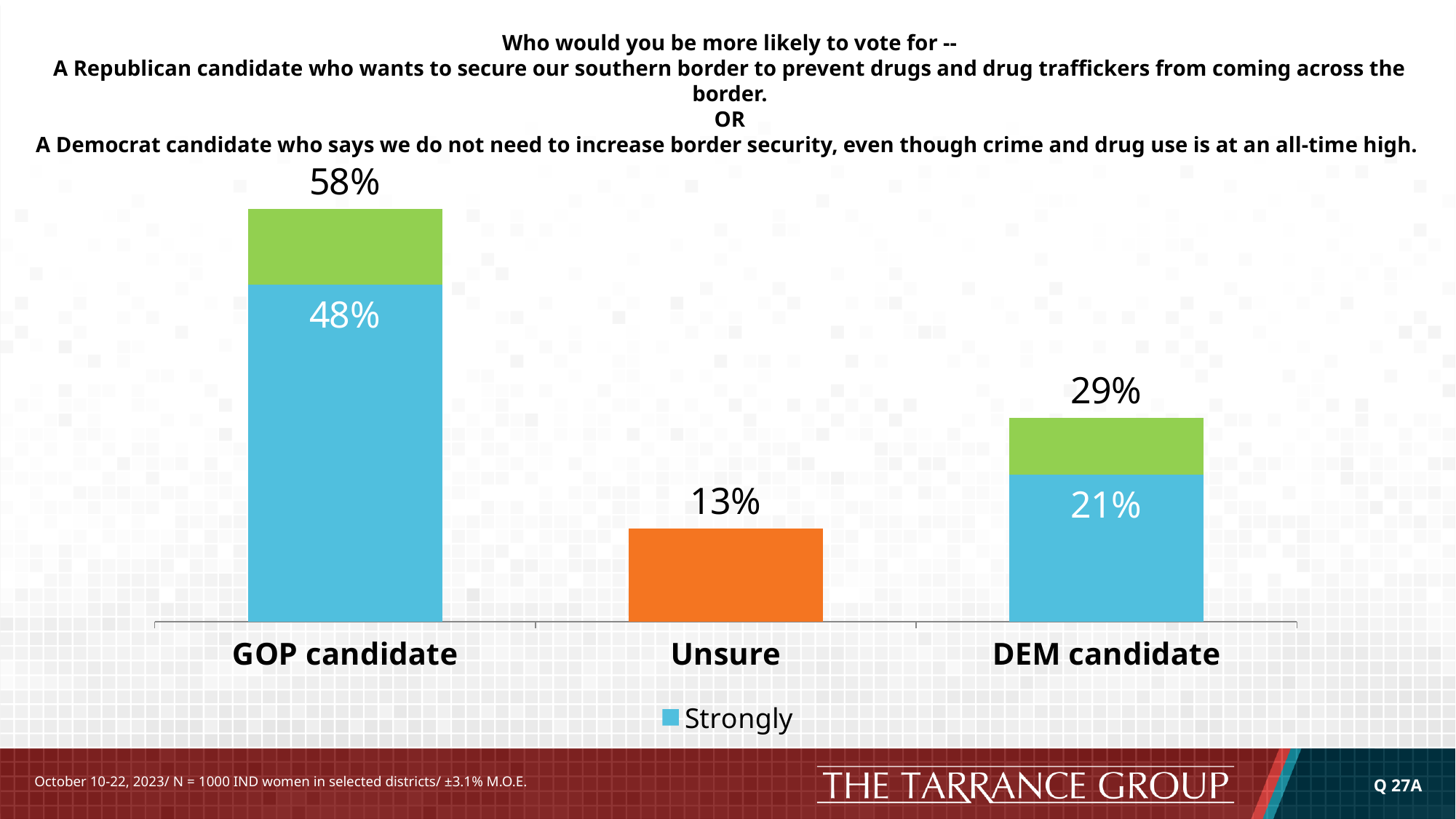
What is the difference between the 'Strongly' values for GOP candidate and DEM candidate? 27% What is the 'Strongly' value for DEM candidate? 21% What is the value for Unsure? 13% Which category has the lowest value? Unsure What is the total value shown for GOP candidate? 58% What is the total value shown for DEM candidate? 29% What is the 'Strongly' value for GOP candidate? 48% What kind of chart is shown on the slide? Bar chart How many categories are shown on the x axis? 3 Which is larger, the 'Strongly' value for DEM candidate or the value for Unsure? DEM candidate What is the difference between the total for GOP candidate and the total for DEM candidate? 29% Which category has the highest total value? GOP candidate